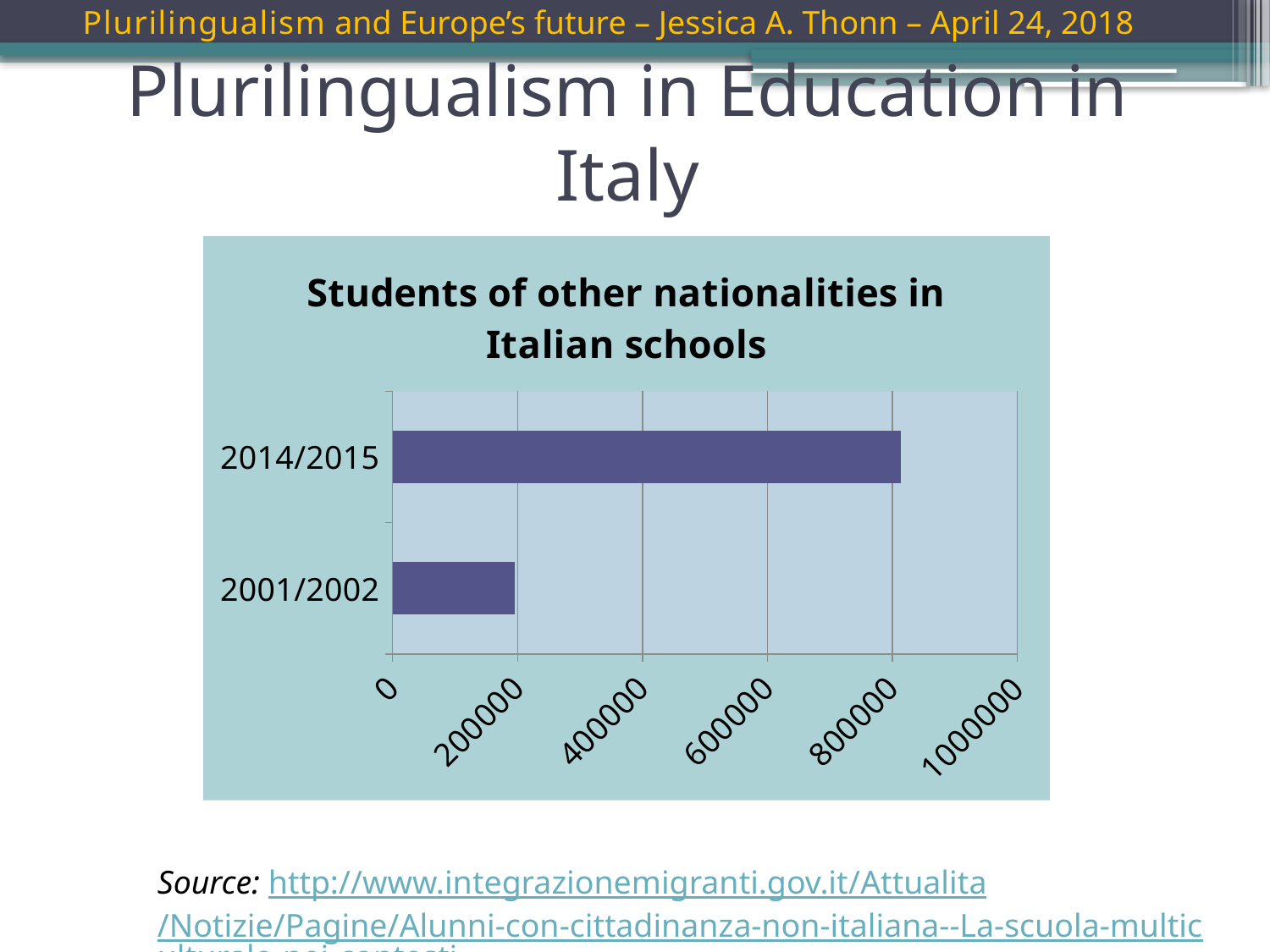
Which school year has the highest number of students of other nationalities? 2014/2015 What kind of chart is shown on the slide? bar chart Which school year has the lowest number of students of other nationalities? 2001/2002 What is the title of the chart? Students of other nationalities in Italian schools How many categories (school years) are plotted in the chart? 2 Is the value for 2001/2002 greater or less than 400000? less Is the value for 2014/2015 greater or less than 600000? greater Is the value for 2014/2015 greater or less than 1000000? less What is the highest value shown on the horizontal axis of the chart? 1000000 Which is larger, the value for 2014/2015 or the value for 2001/2002? 2014/2015